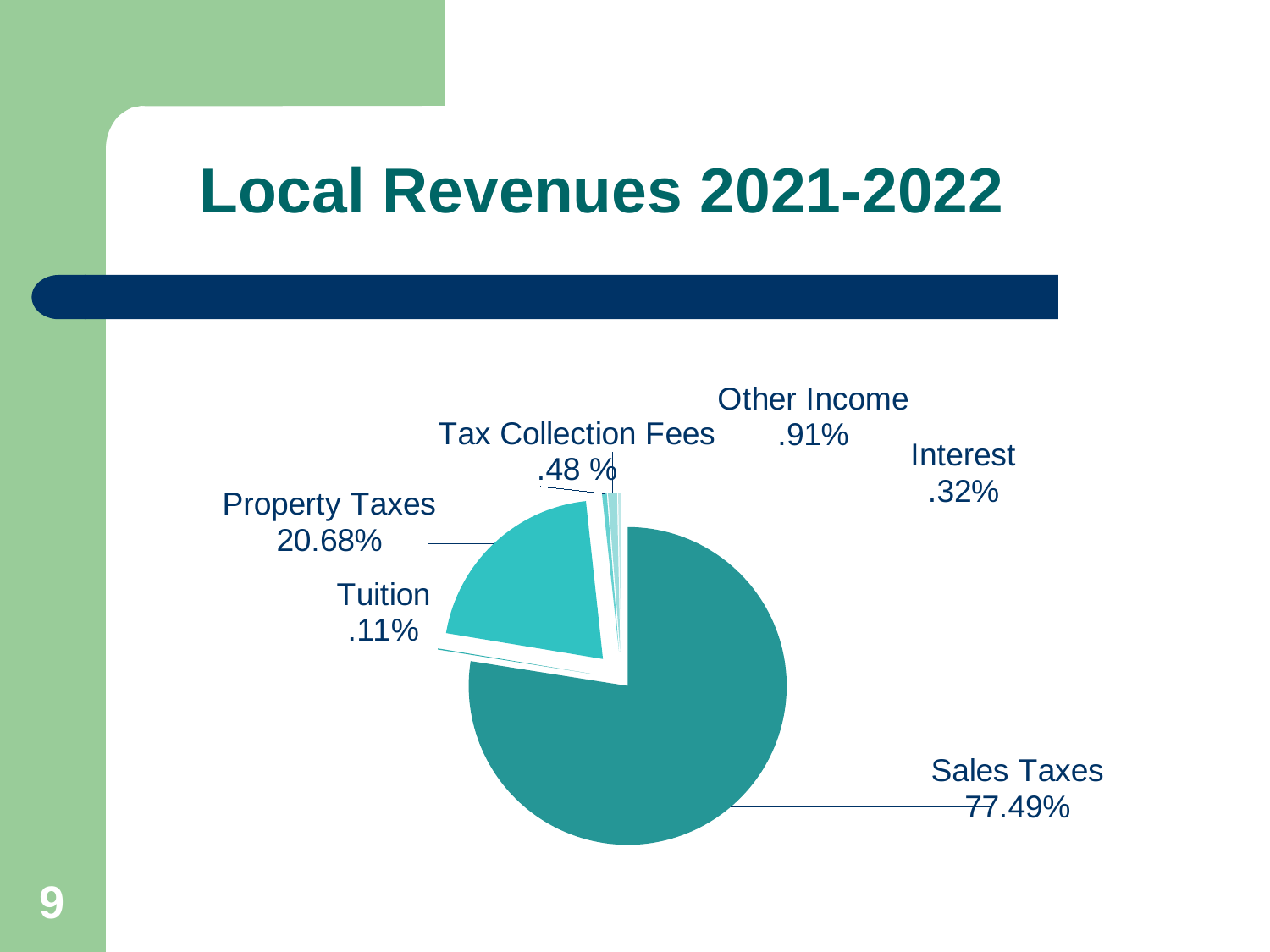
What percentage is shown for Interest? .32% What is the title of the slide containing the chart? Local Revenues 2021-2022 Which revenue source has the smallest slice of the pie? Tuition Which is larger, the share for Other Income or the share for Tax Collection Fees? Other Income Which revenue source has the largest slice of the pie? Sales Taxes What share of local revenues comes from Sales Taxes? 77.49% What is the difference in percentage points between Sales Taxes and Property Taxes? 56.81 percentage points How many revenue categories are shown in the pie chart? 6 What kind of chart is shown on the slide? Pie chart What percentage is shown for Tuition? .11% What percentage is shown for Other Income? .91% What percentage is shown for Property Taxes? 20.68%